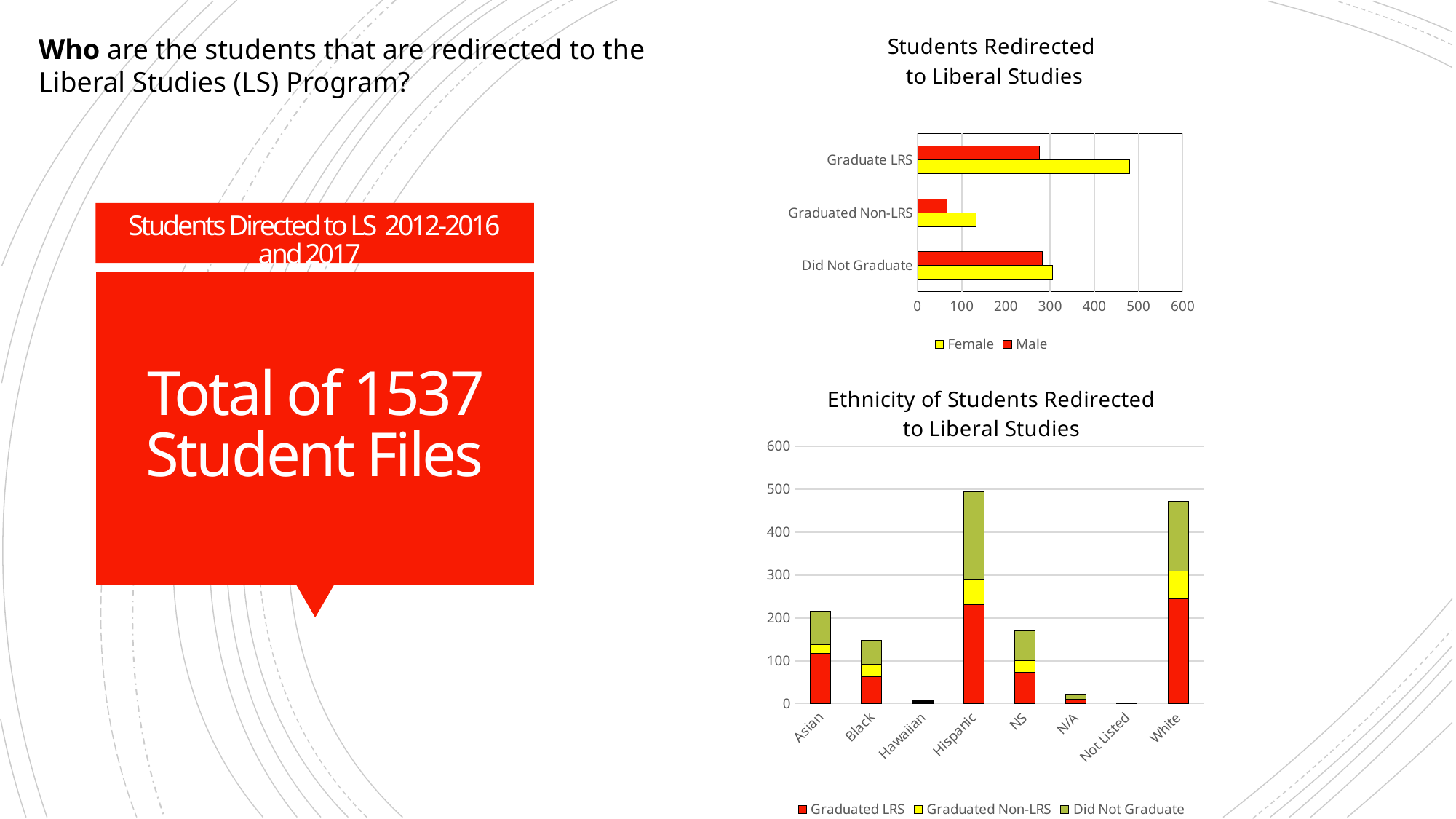
How many ethnicity categories are shown on the 'Ethnicity of Students Redirected to Liberal Studies' chart? 8 How many series does the legend of the 'Ethnicity of Students Redirected to Liberal Studies' chart list? 3 What kind of chart is the 'Students Redirected to Liberal Studies' chart? bar chart In the 'Ethnicity of Students Redirected to Liberal Studies' chart, which has the taller stacked bar, Asian or Black? Asian In the 'Ethnicity of Students Redirected to Liberal Studies' chart, which ethnicity has the tallest stacked bar? Hispanic In the 'Students Redirected to Liberal Studies' chart, which category has the highest Female value? Graduate LRS In the 'Ethnicity of Students Redirected to Liberal Studies' chart, is the total stacked bar for Hispanic greater or less than 400? greater In the 'Students Redirected to Liberal Studies' chart, which is larger for Graduate LRS, Female or Male? Female How many categories are shown on the 'Students Redirected to Liberal Studies' chart? 3 In the 'Students Redirected to Liberal Studies' chart, is the Male value for Graduated Non-LRS greater or less than 100? less How many series does the legend of the 'Students Redirected to Liberal Studies' chart list? 2 In the 'Students Redirected to Liberal Studies' chart, is the Female value for Graduate LRS greater or less than 400? greater